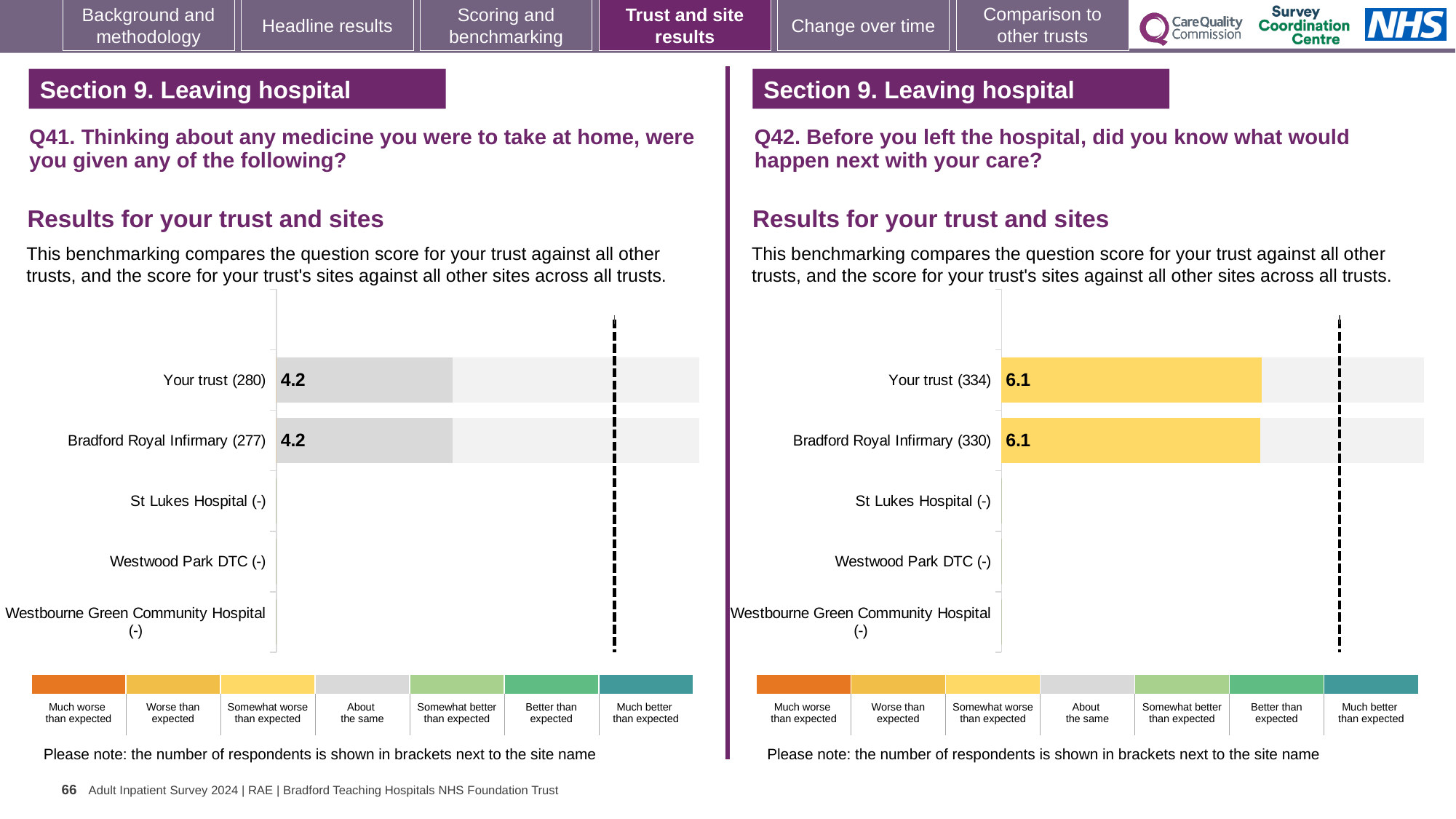
What kind of chart is used on the Q42 chart (right)? Bar chart On the Q41 chart (left), which benchmark category does the colour of the Your trust bar correspond to? About the same On the Q42 chart (right), what is the score for Your trust? 6.1 On the Q41 chart (left), what is the score for Your trust? 4.2 On the Q41 chart (left), what is the score for Bradford Royal Infirmary? 4.2 On the Q41 chart (left), how many sites or categories are listed on the vertical axis? 5 On the Q41 chart (left), how many respondents are shown in brackets for Bradford Royal Infirmary? 277 On the Q42 chart (right), what is the score for Bradford Royal Infirmary? 6.1 On the Q42 chart (right), which benchmark category does the colour of the Your trust bar correspond to? Somewhat worse than expected On the Q41 chart (left), how many sites show no score (marked with a dash)? 3 On the Q42 chart (right), how many respondents are shown in brackets for Your trust? 334 On the Q42 chart (right), what is the difference between the score for Your trust and the score for Bradford Royal Infirmary? 0